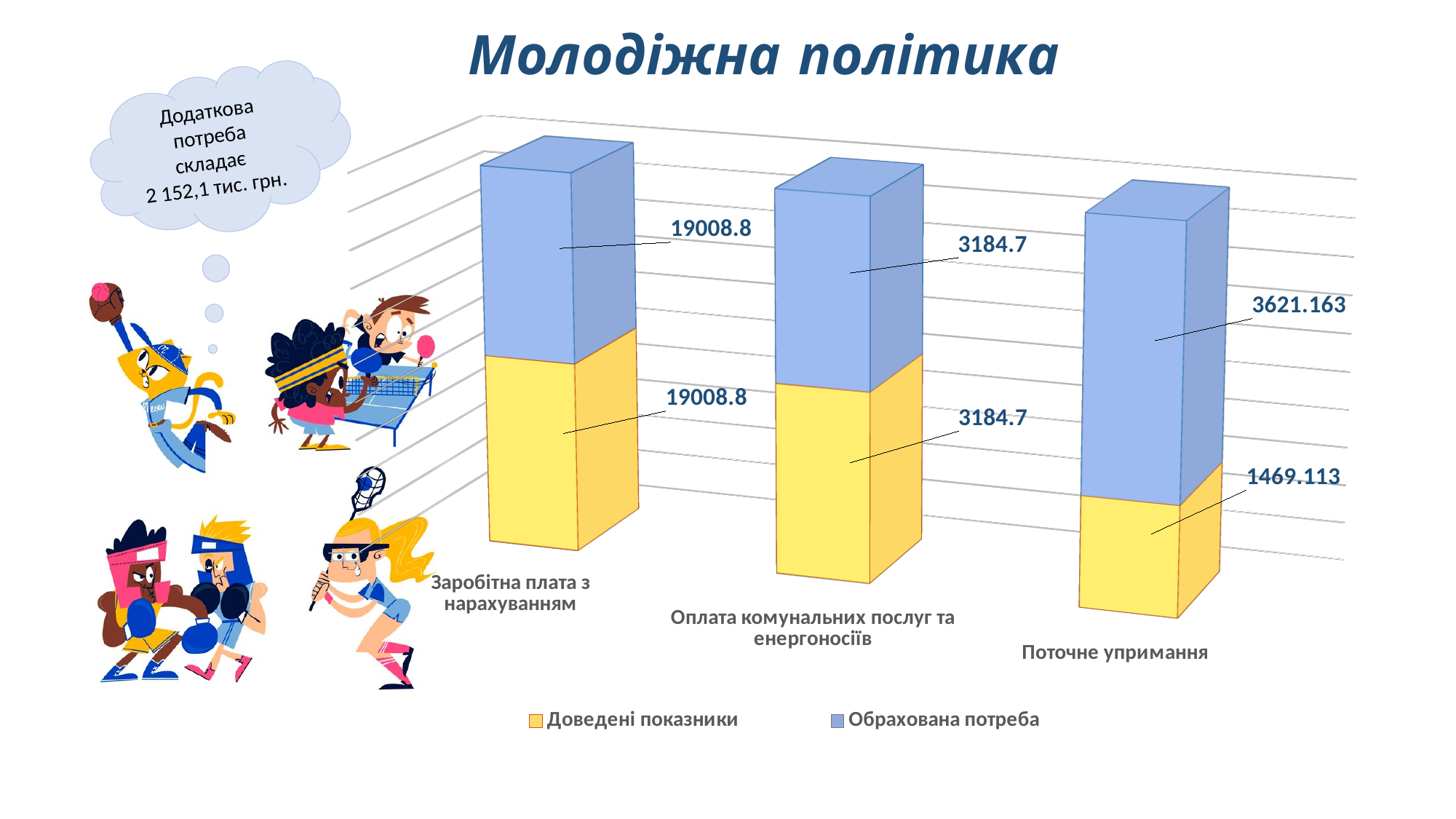
Which category has the lowest value for Доведені показники? Поточне упримання What is the value of Обрахована потреба for Поточне упримання? 3621.163 What is the total of the stacked bar for Поточне упримання? 5090.276 For Поточне упримання, what is the difference between Обрахована потреба and Доведені показники? 2152.05 For Поточне упримання, which is larger: Доведені показники or Обрахована потреба? Обрахована потреба What is the value of Доведені показники for Поточне упримання? 1469.113 What is the value of Доведені показники for Оплата комунальних послуг та енергоносіїв? 3184.7 How many categories are shown on the x axis of the chart? 3 How many series does the legend list? 2 Which category has the highest value for Доведені показники? Заробітна плата з нарахуванням What kind of chart is shown on the slide? Stacked bar chart What is the value of Обрахована потреба for Заробітна плата з нарахуванням? 19008.8